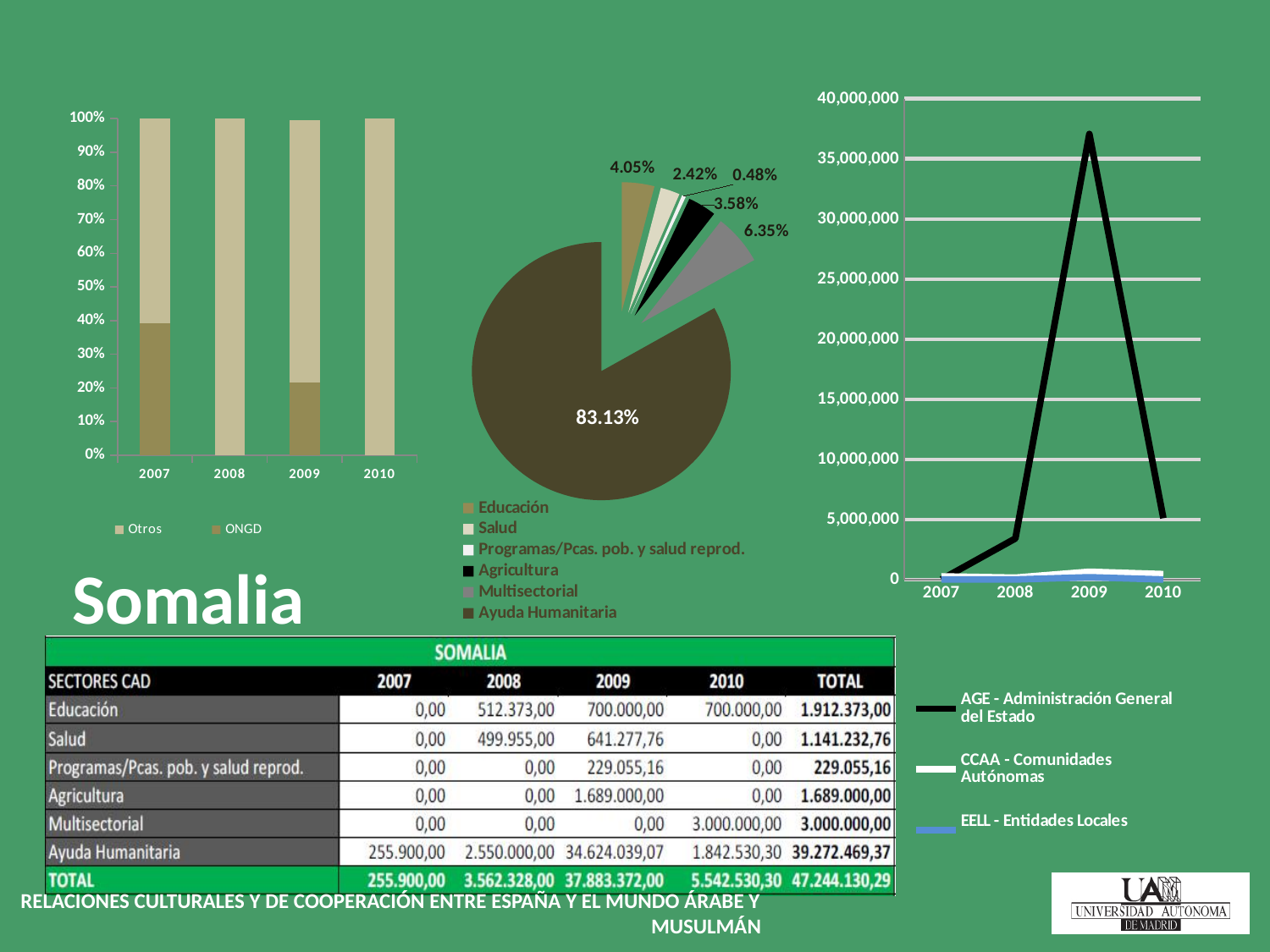
How many series does the legend of the line chart on the right list? 3 On the line chart on the right, in which year does the AGE series reach its highest value? 2009 What kind of chart is the chart on the left showing Otros and ONGD? bar chart On the pie chart, what share does Educación have? 4.05% On the line chart on the right, is the AGE value for 2009 greater or less than 35,000,000? greater On the pie chart, what share does Multisectorial have? 6.35% On the pie chart, which sector has the largest slice? Ayuda Humanitaria On the pie chart, which is larger, the Salud slice or the Agricultura slice? Agricultura On the pie chart, which sector has the smallest slice? Programas/Pcas. pob. y salud reprod. On the bar chart on the left, is the ONGD value for 2007 greater or less than 30%? greater On the pie chart, what share does Ayuda Humanitaria have? 83.13% On the pie chart, what is the difference between the Multisectorial share and the Educación share? 2.30%